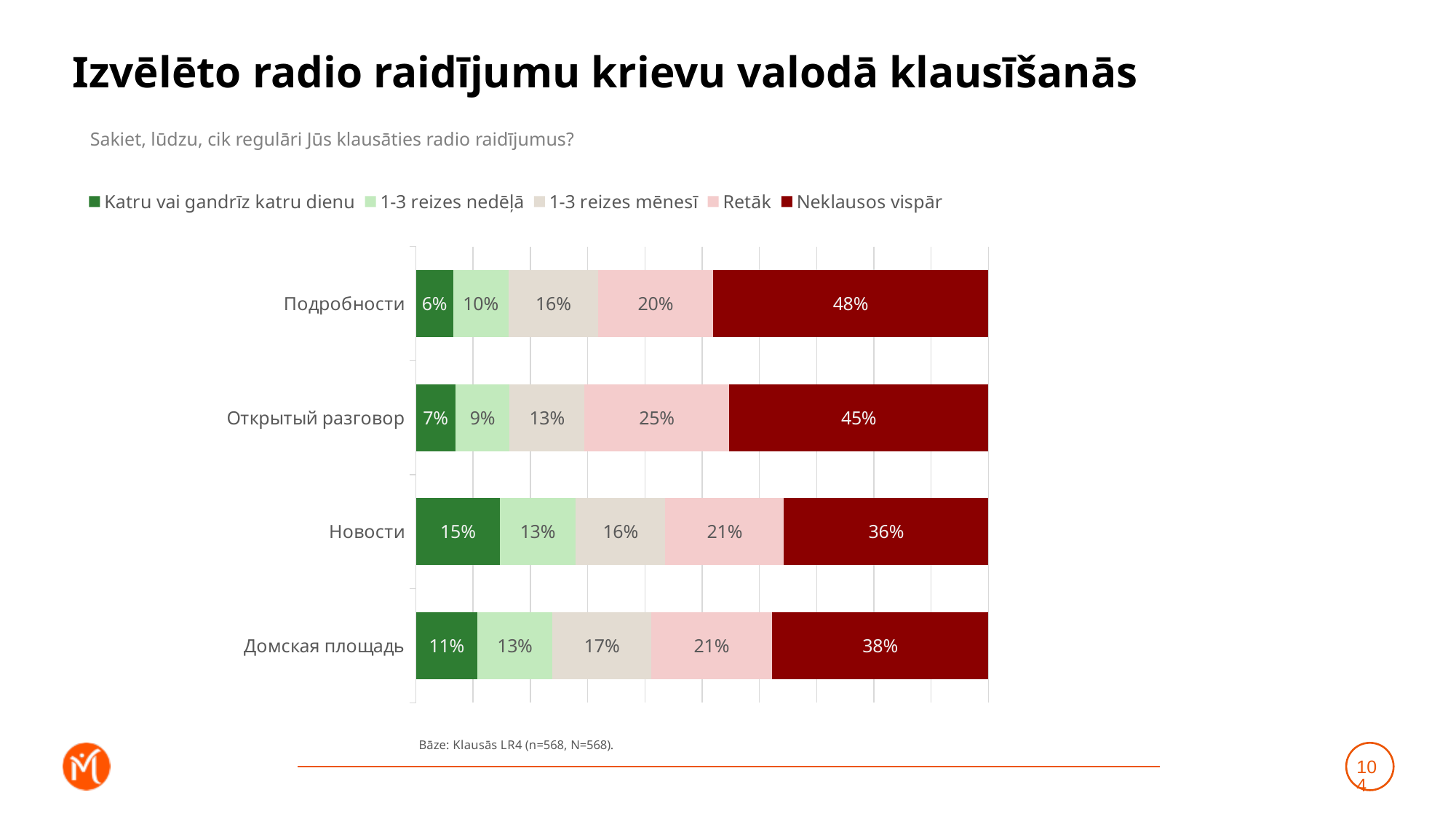
What kind of chart is shown on the slide? Stacked bar chart Which programme has the lowest 'Neklausos vispār' share? Новости Which is larger: the '1-3 reizes mēnesī' value for Домская площадь or for Открытый разговор? Домская площадь How many programmes (categories) are shown in the chart? 4 What is the 'Retāk' value for Открытый разговор? 25% What is the difference between the 'Neklausos vispār' values for Подробности and Домская площадь? 10 percentage points What is the value for Новости in the 'Katru vai gandrīz katru dienu' series? 15% How many series does the legend list? 5 Which programme has the highest 'Katru vai gandrīz katru dienu' share? Новости What is the total of the stacked bar for Новости? 101% Which legend entry is shown in dark red? Neklausos vispār What percentage of respondents say they never listen (Neklausos vispār) to Подробности? 48%